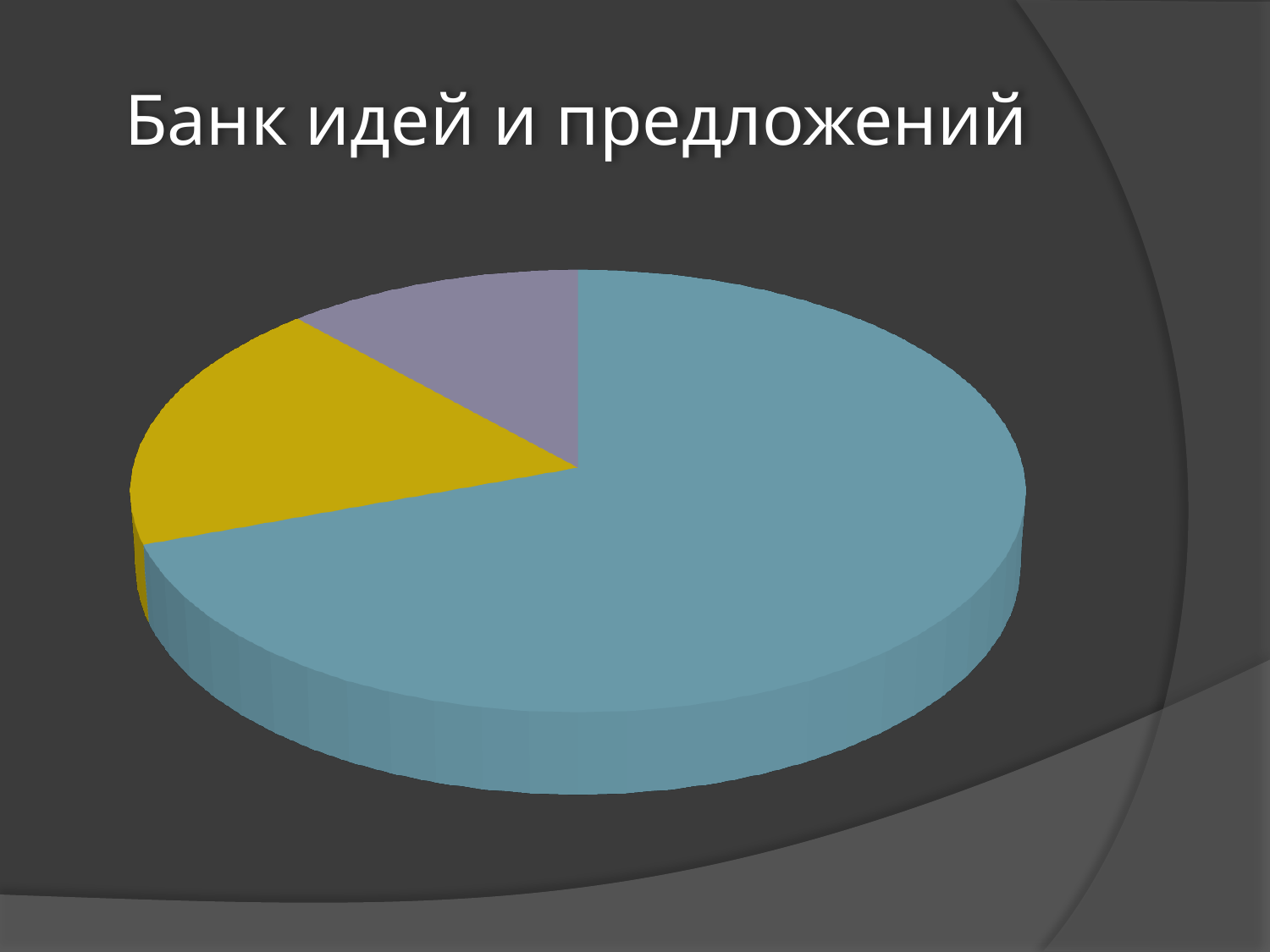
Which colour slice is the largest in the pie chart? blue Does the pie chart display a legend? No How many slices does the pie chart have? 3 Which slice is larger, the yellow one or the purple one? yellow What is the title of the slide containing the pie chart? Банк идей и предложений What kind of chart is shown on the slide? pie chart Which colour slice is the smallest in the pie chart? purple Which slice is larger, the blue one or the yellow one? blue